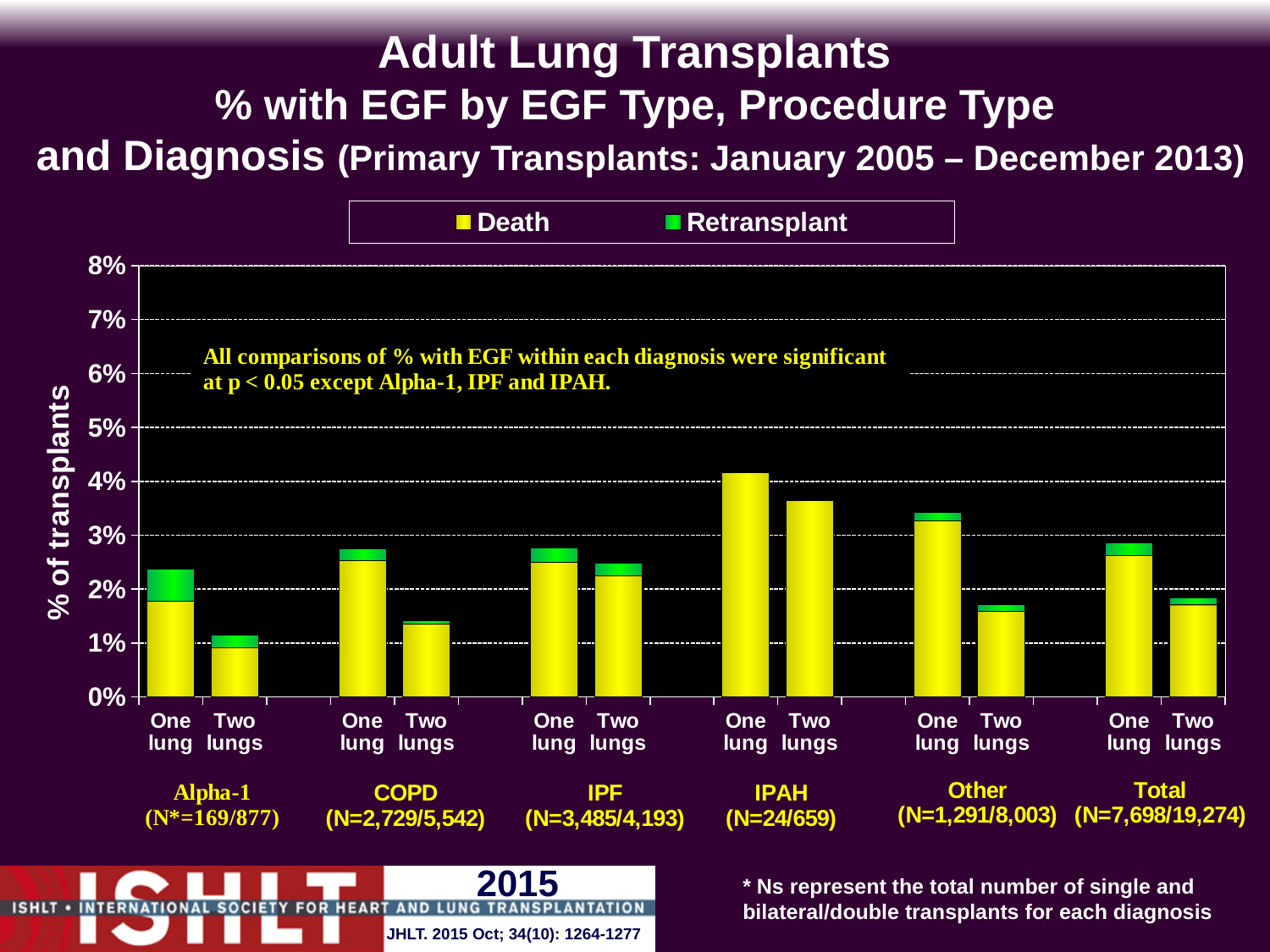
How many series does the legend list? 2 Within the IPAH group, which bar is taller: One lung or Two lungs? One lung Is the total value for Other One lung greater or less than 3%? greater Is the total value for Total Two lungs greater or less than 2%? less What are the two series named in the legend? Death and Retransplant How many diagnosis groups are shown along the x axis? 6 Is the total value for IPAH One lung greater or less than 3%? greater What kind of chart is shown on the slide? bar chart What is the label on the y axis? % of transplants How many bars are plotted in the chart in total? 12 Which bar has the highest total % of transplants with EGF? IPAH, One lung